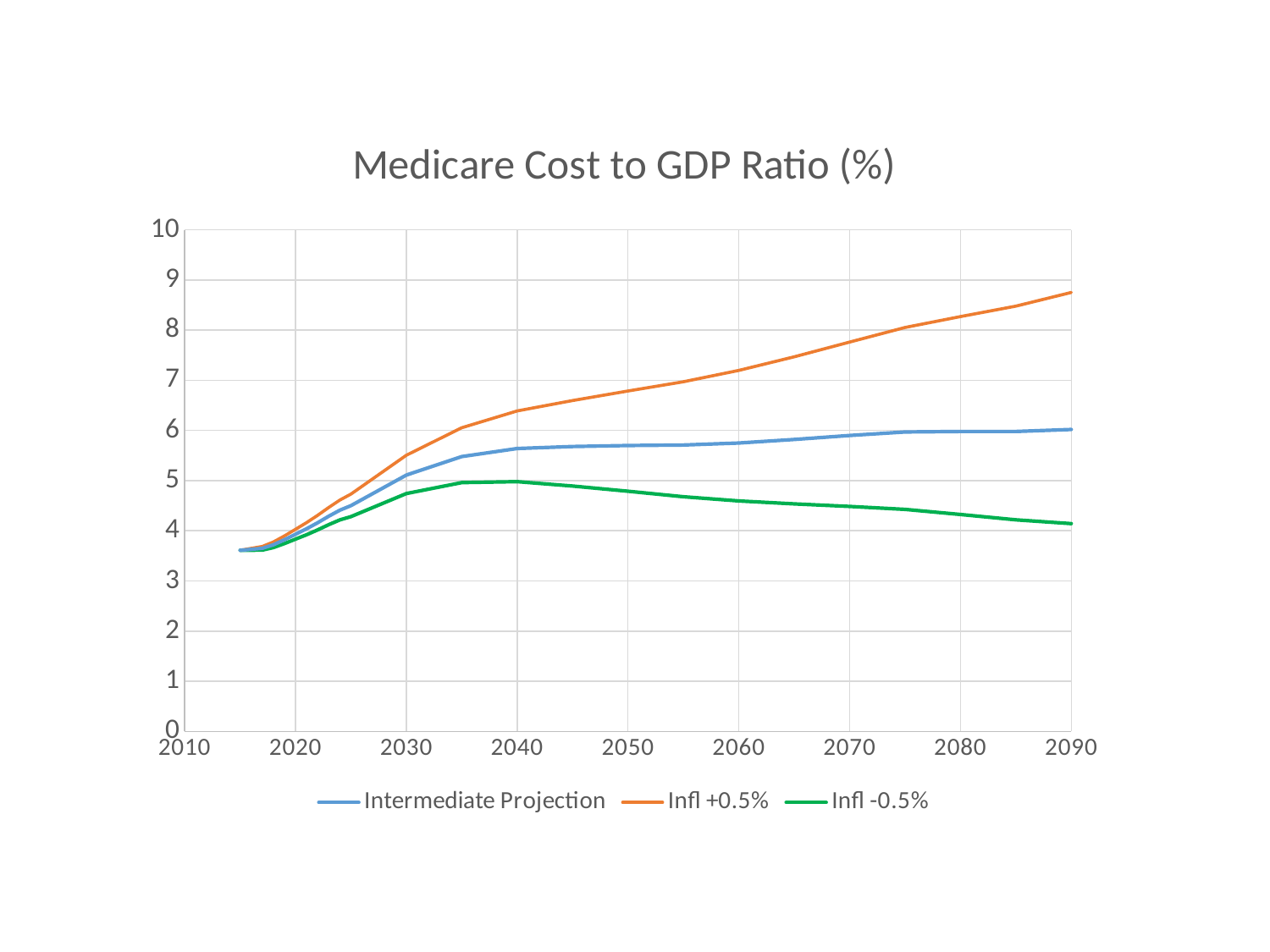
Which series has the highest value in 2090? Infl +0.5% Which series is shown in green in the legend? Infl -0.5% What is the title of the chart? Medicare Cost to GDP Ratio (%) How many series does the legend list? 3 Which series has the lowest value in 2090? Infl -0.5% In 2050, which is larger, Intermediate Projection or Infl -0.5%? Intermediate Projection Is the value for Infl +0.5% in 2090 greater or less than 8? greater Is the value for Infl -0.5% in 2090 greater or less than 5? less What kind of chart is shown on the slide? line chart Is the value for Infl +0.5% in 2040 greater or less than 6? greater Does the Infl -0.5% line rise or fall from 2040 to 2090? fall